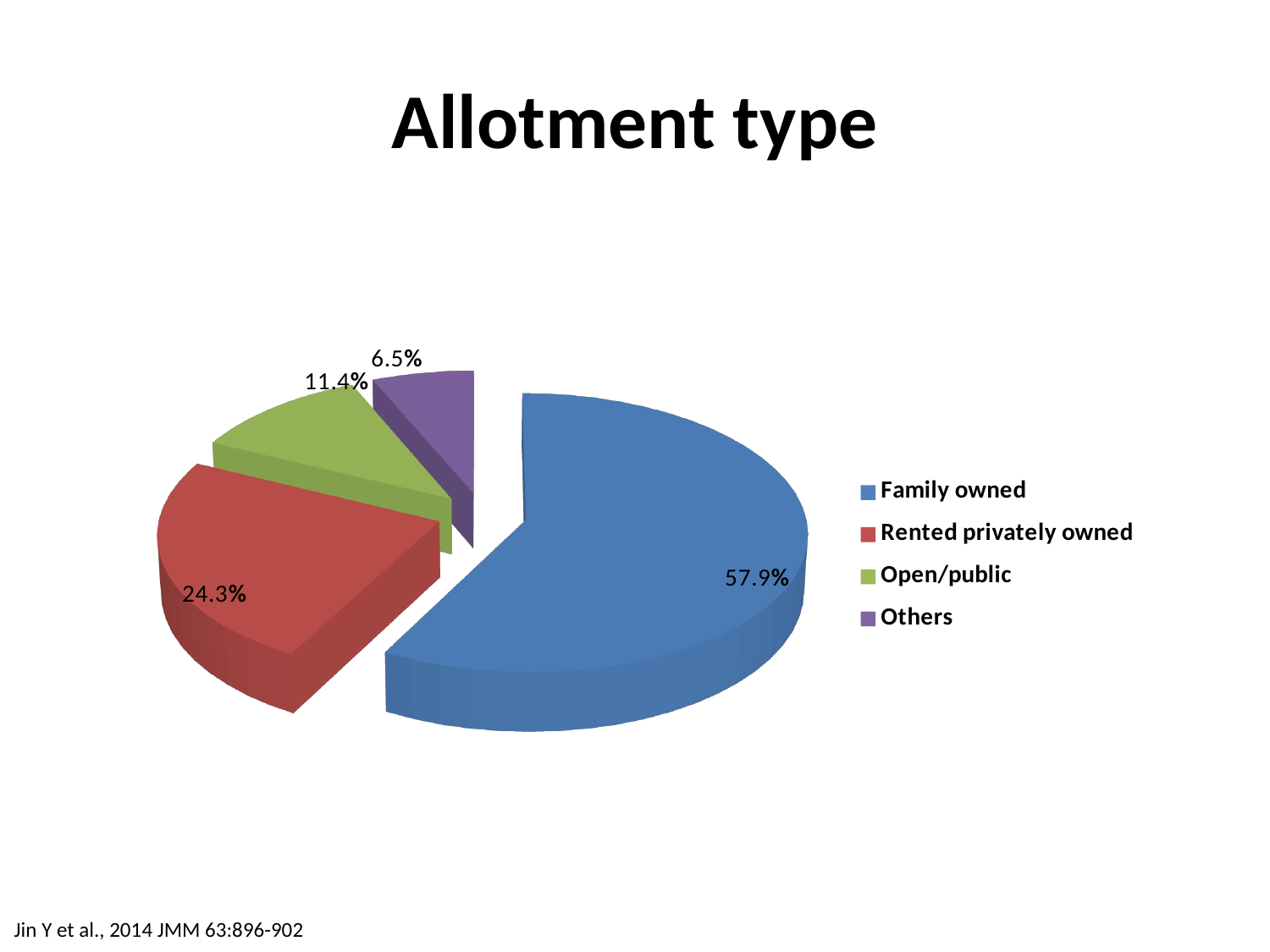
What type of chart is shown on the slide? pie chart What colour is the Rented privately owned slice? red Which is larger, the Open/public share or the Others share? Open/public What share of the pie is Rented privately owned? 24.3% How many categories does the pie chart show? 4 What share of the pie is Others? 6.5% What is the difference between the Family owned and Rented privately owned shares? 33.6% Which category has the smallest slice of the pie? Others Which category has the largest slice of the pie? Family owned What share of the pie is Family owned? 57.9% What is the title of the chart? Allotment type